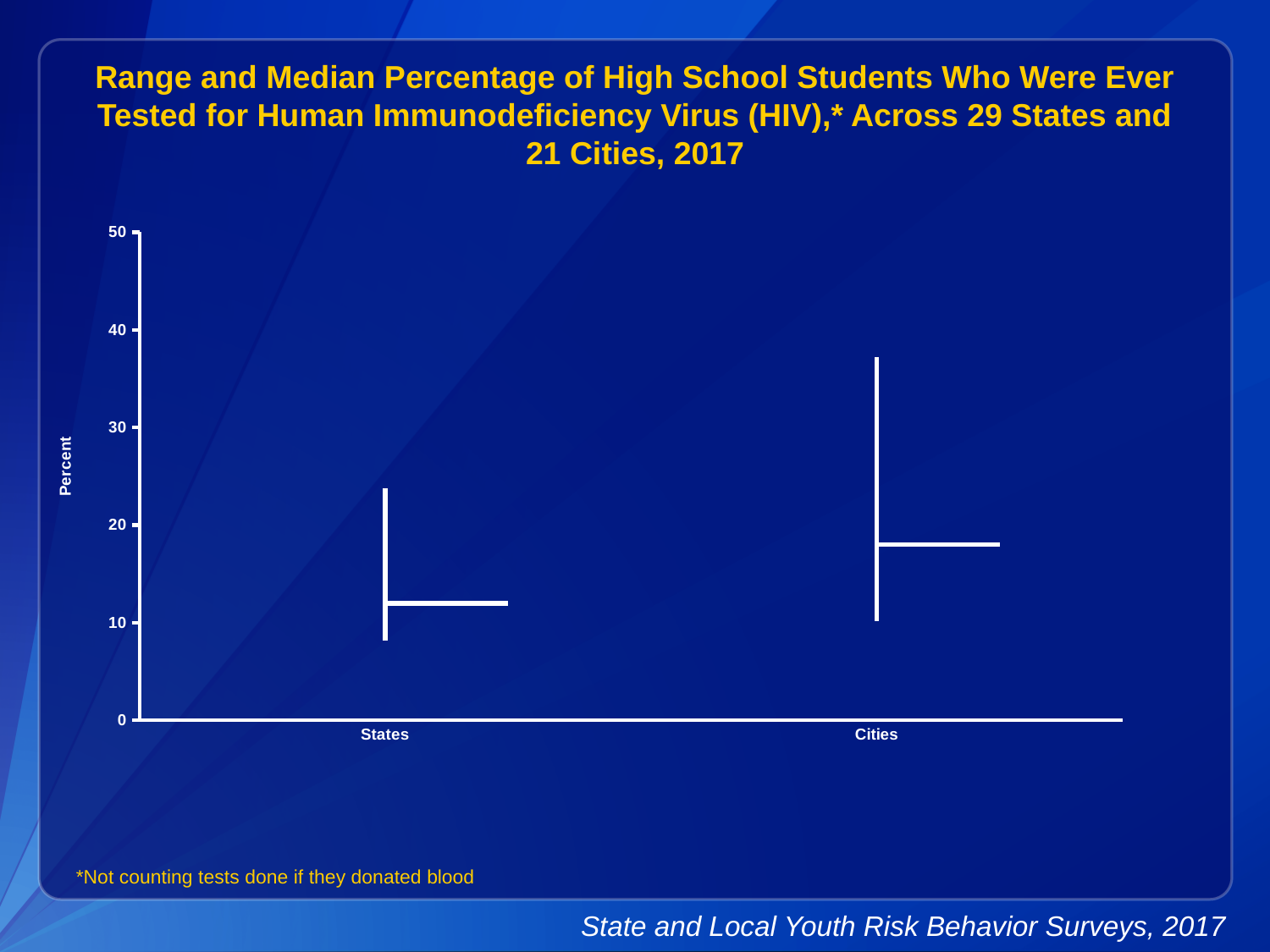
What is the label on the y axis of the chart? Percent Is the top of the range for Cities greater or less than 30? greater Is the top of the range for Cities greater or less than 40? less Is the median value for States greater or less than 20? less Which category has the higher median percentage, States or Cities? Cities What is the highest value shown on the y axis? 50 Which category shows the wider range of percentages? Cities How many categories are shown on the x axis of the chart? 2